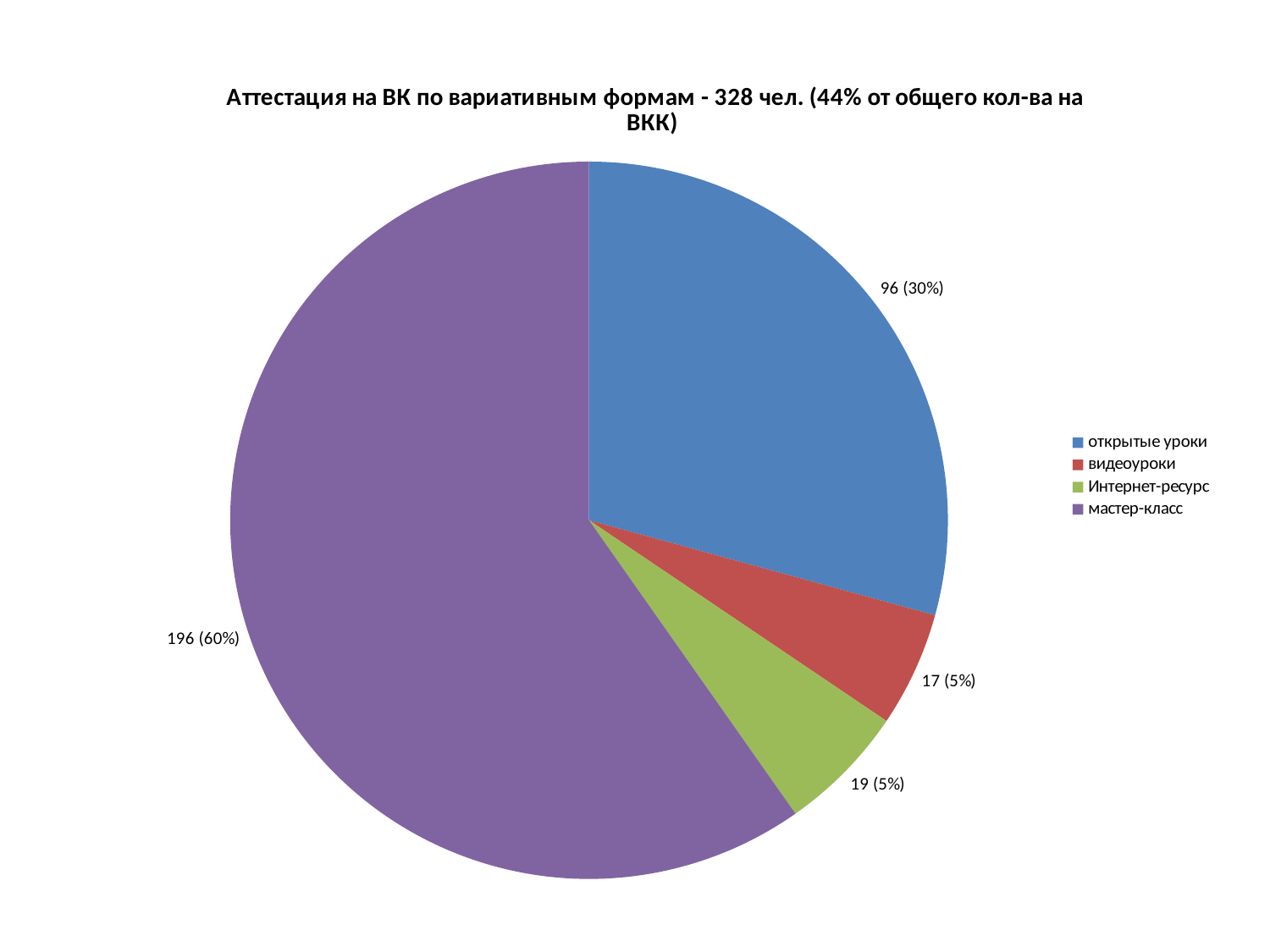
How many slices does the pie chart have? 4 Which category has the smallest slice? видеоуроки What kind of chart is shown on the slide? pie chart How many entries does the legend list? 4 Which is larger, the value for открытые уроки or the value for Интернет-ресурс? открытые уроки What is the value shown for Интернет-ресурс? 19 (5%) What is the value shown for мастер-класс? 196 (60%) What is the value shown for видеоуроки? 17 (5%) Which category has the largest slice? мастер-класс What is the value shown for открытые уроки? 96 (30%) What is the difference between the values for мастер-класс and открытые уроки? 100 What share of the pie does открытые уроки take? 30%